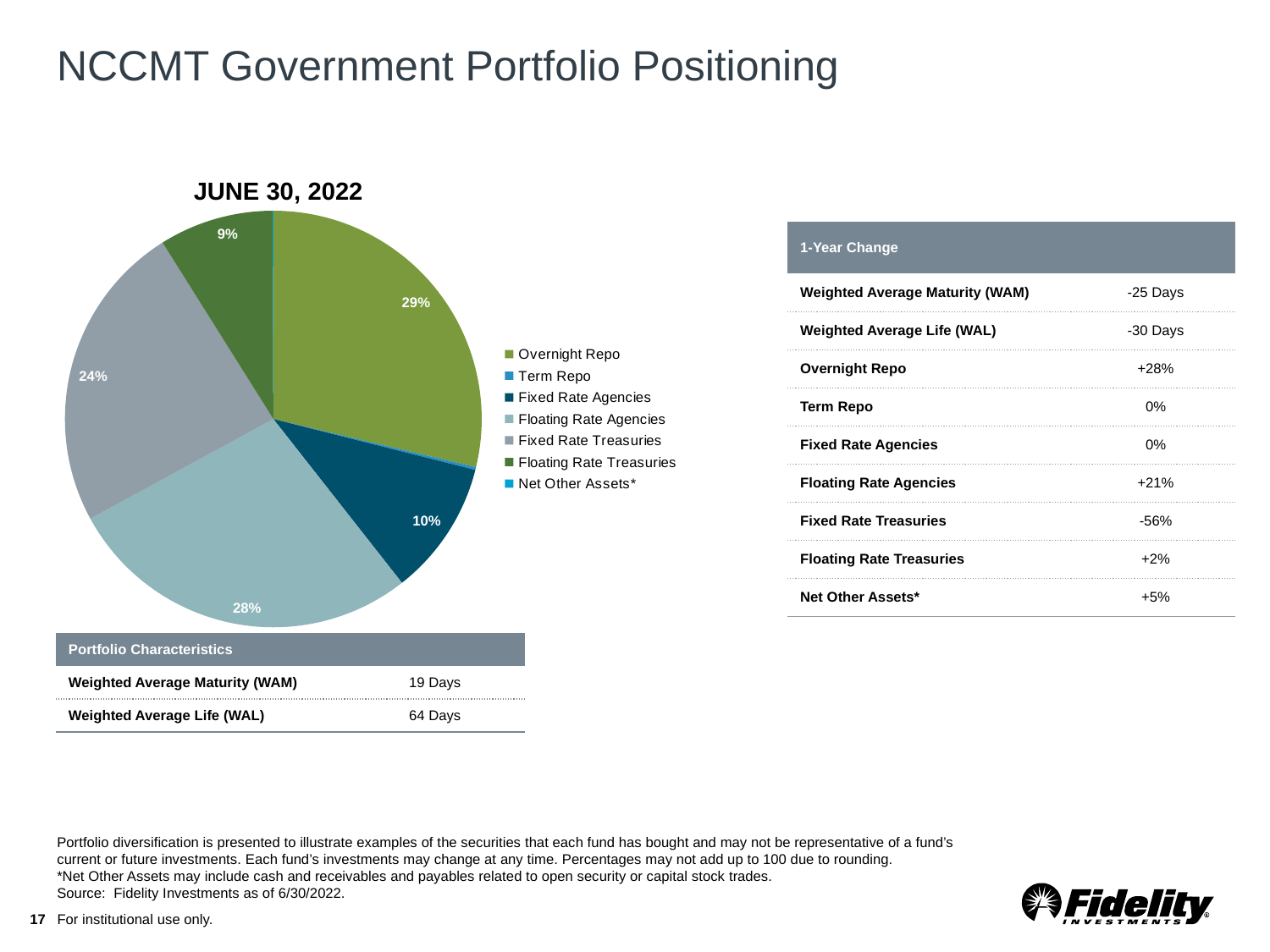
How many categories are listed in the pie chart's legend? 7 What percentage of the pie chart is Floating Rate Agencies? 28% What share of the pie chart is Floating Rate Treasuries? 9% What share of the pie chart does Overnight Repo represent? 29% How many percentage points larger is the Overnight Repo slice than the Fixed Rate Agencies slice? 19 What type of chart is shown on the slide? Pie chart Which is larger in the pie chart, Fixed Rate Treasuries or Fixed Rate Agencies? Fixed Rate Treasuries What percentage does the pie chart show for Fixed Rate Agencies? 10% Which category has the largest slice in the pie chart? Overnight Repo What is the difference in percentage points between Floating Rate Agencies and Fixed Rate Treasuries? 4 What is the title of the pie chart? JUNE 30, 2022 What is the value shown for Fixed Rate Treasuries in the pie chart? 24%